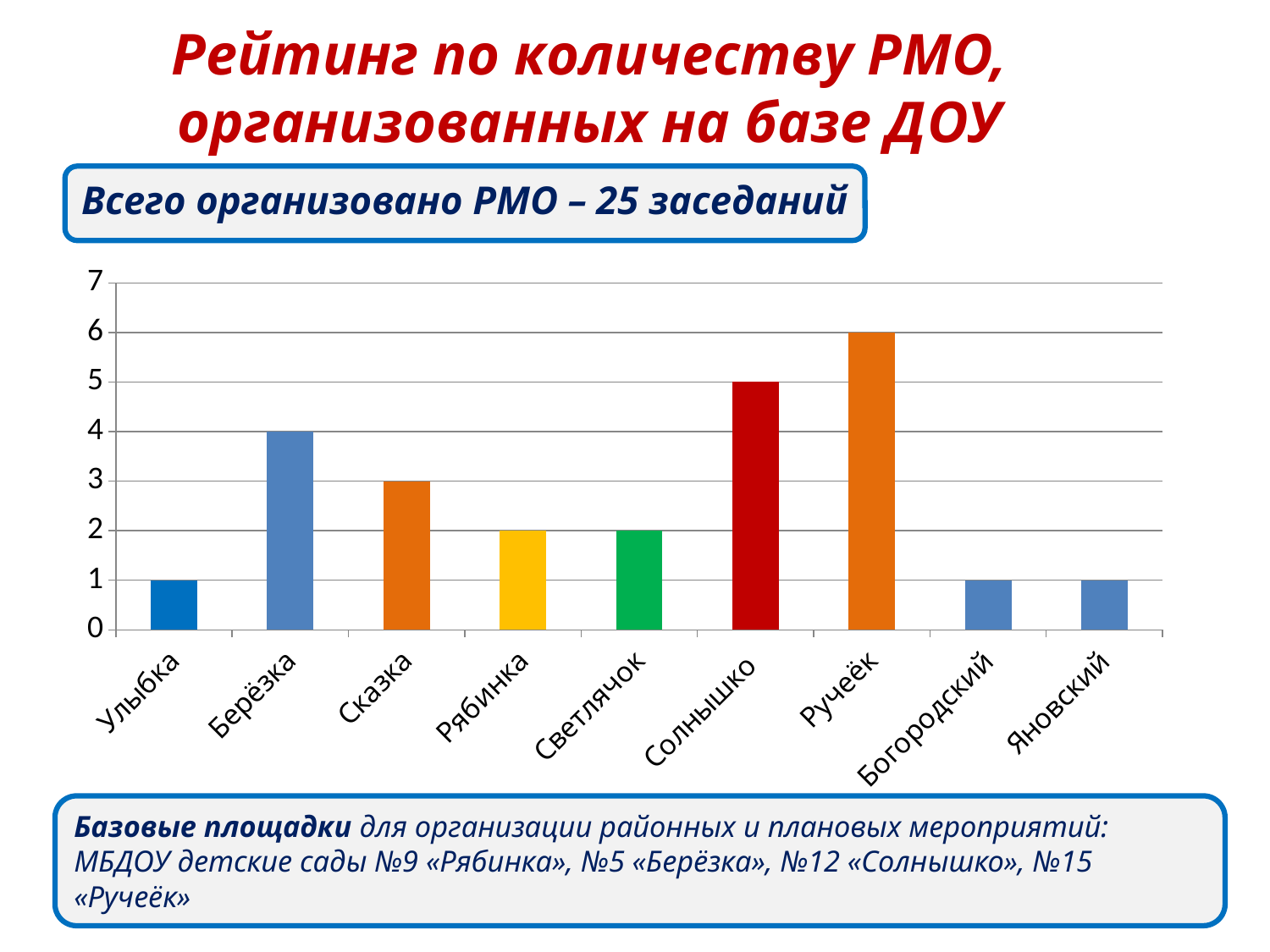
What is the value for Солнышко in the chart? 5 What is the value for Берёзка in the chart? 4 Which category has the highest bar in the chart? Ручеёк Which is larger, the value for Солнышко or the value for Сказка? Солнышко What is the highest value shown on the vertical axis of the chart? 7 What is the value for Ручеёк in the chart? 6 What kind of chart is shown on the slide? bar chart What is the value for Сказка in the chart? 3 What is the difference between the values for Ручеёк and Берёзка? 2 Is the value for Берёзка greater or less than 3? greater According to the text box above the chart, how many РМО meetings were organised in total? 25 How many categories (kindergartens) are shown on the x axis of the chart? 9